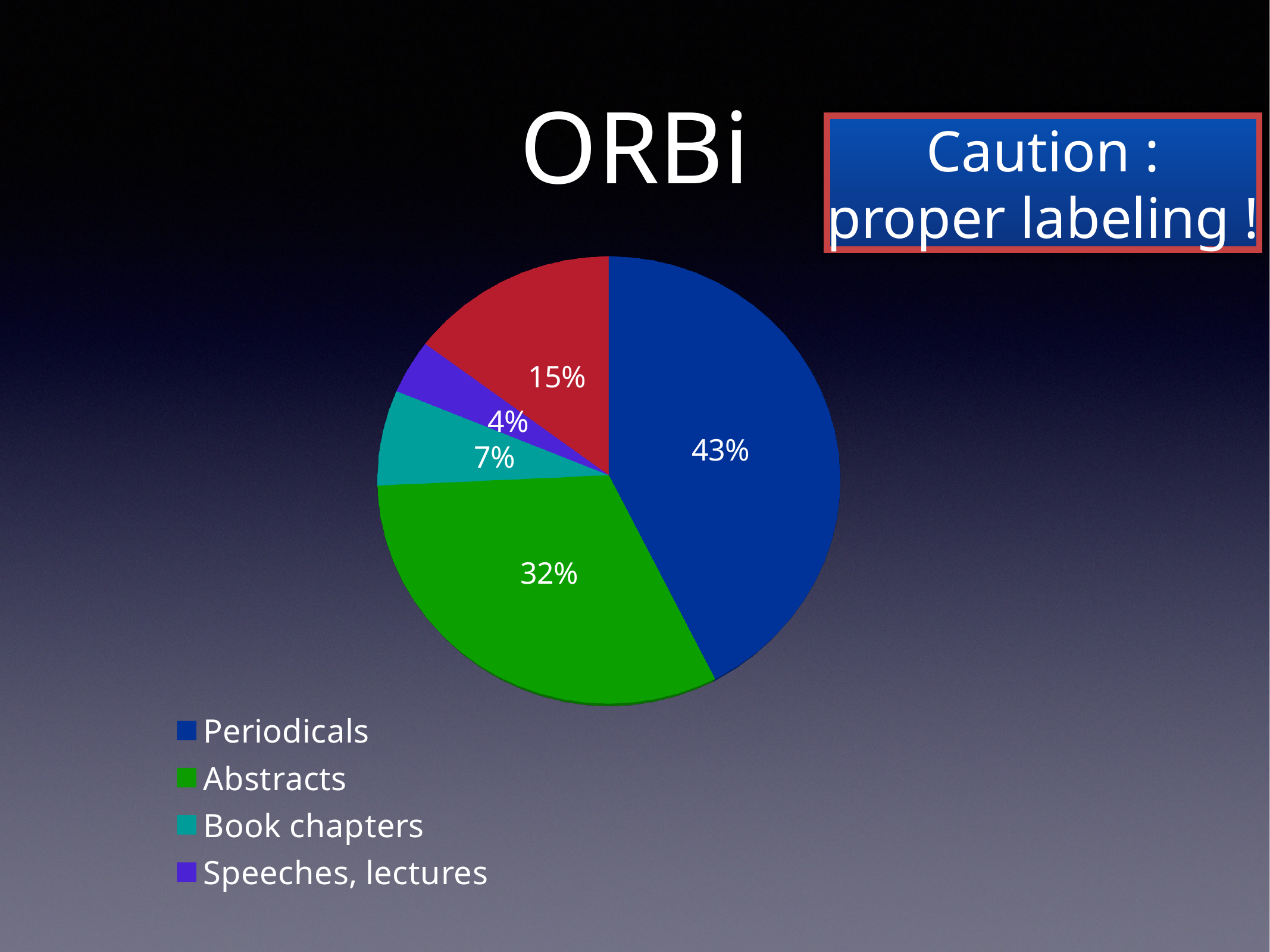
How many slices does the pie chart have? 5 What is the difference between the Periodicals share and the Abstracts share? 11% Which legend category has the smallest slice of the pie? Speeches, lectures What share of the pie does Book chapters have? 7% What share of the pie does Periodicals have? 43% How many entries does the legend list? 4 What type of chart is shown on the slide? pie chart Which is larger, the Book chapters slice or the Speeches, lectures slice? Book chapters What share of the pie does Abstracts have? 32% Which category has the largest slice of the pie? Periodicals What is the title of the chart? ORBi What share of the pie does Speeches, lectures have? 4%